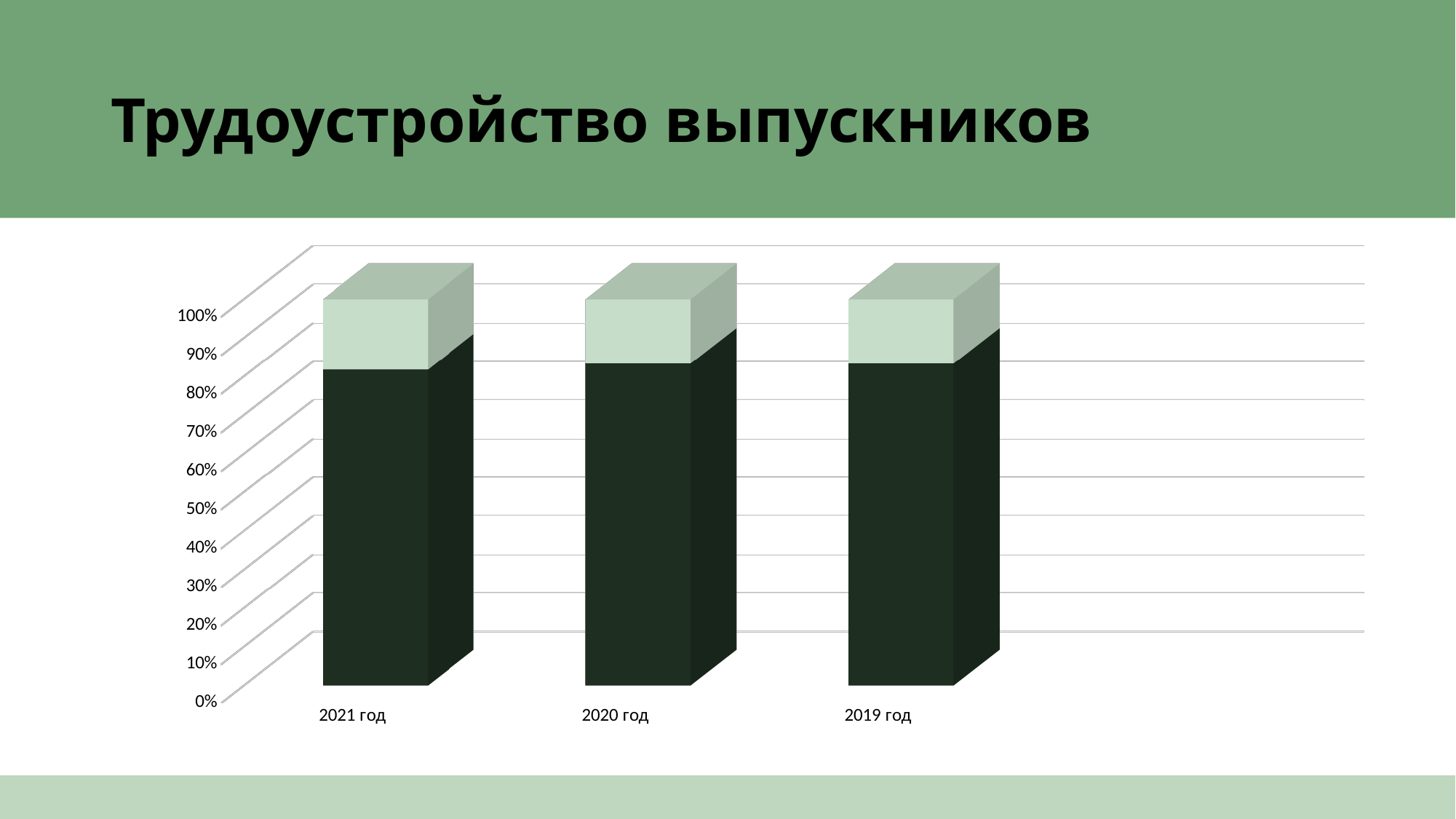
What is the highest value labelled on the vertical axis of the chart? 100% What is the title of the slide above the chart? Трудоустройство выпускников How many stacked segments does each bar in the chart have? 2 Which category is shown first (leftmost) on the x axis? 2021 год What kind of chart is shown on the slide? bar chart How many categories (years) are shown on the x axis of the chart? 3 Is the dark segment for 2021 год greater or less than 90%? less Is the dark segment for 2019 год greater or less than 50%? greater